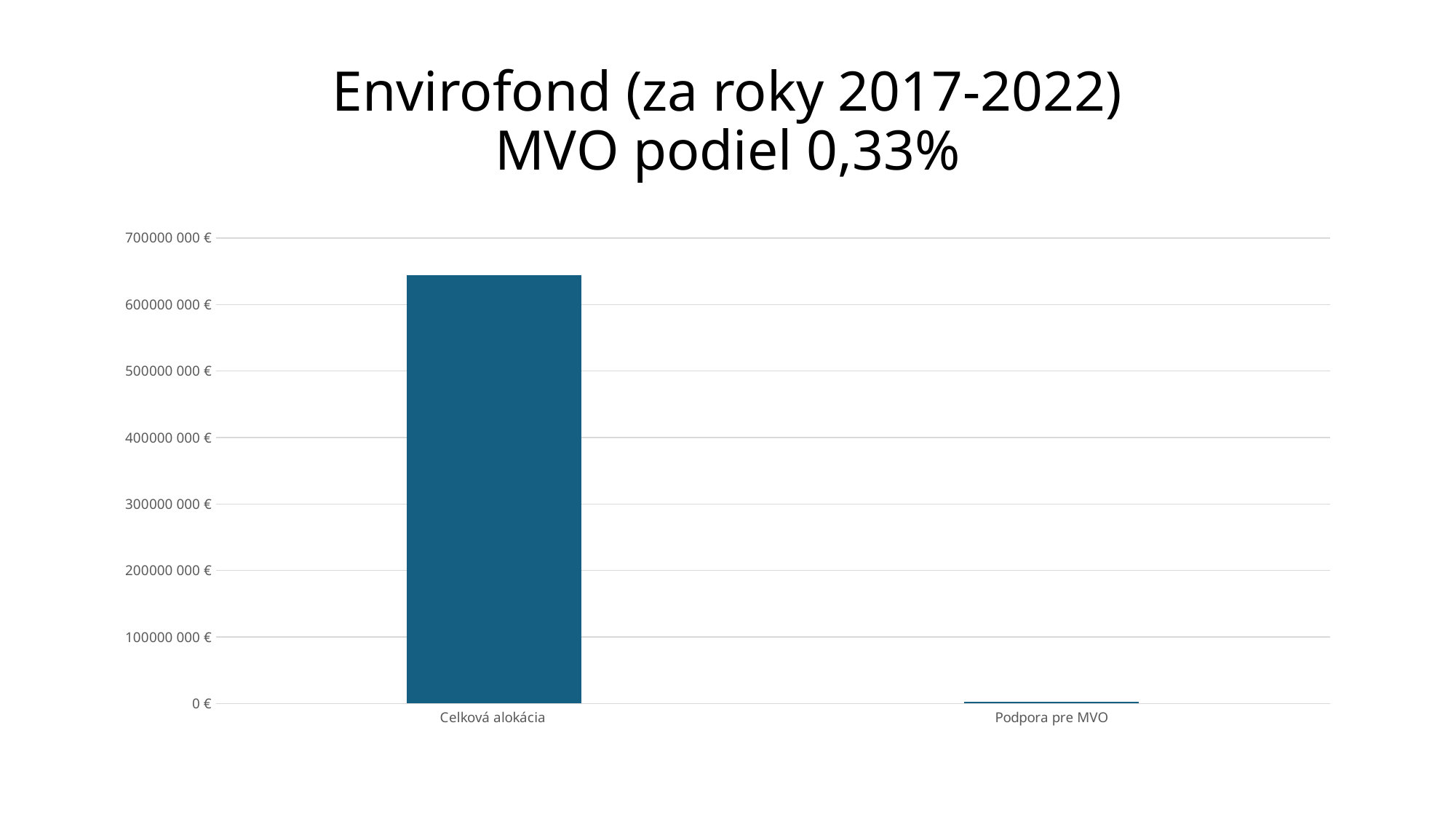
What is the highest value shown on the y axis? 700000 000 € Is the value for Celková alokácia greater or less than 700000 000 €? less Is the value for Podpora pre MVO greater or less than 100000 000 €? less Is the value for Celková alokácia greater or less than 600000 000 €? greater Which category has the highest value? Celková alokácia How many categories are shown on the x axis? 2 Which is larger, the value for Celková alokácia or the value for Podpora pre MVO? Celková alokácia What kind of chart is shown on the slide? bar chart Which category has the lowest value? Podpora pre MVO What MVO share percentage is stated in the chart title? 0,33% What is the title of the chart? Envirofond (za roky 2017-2022) MVO podiel 0,33%